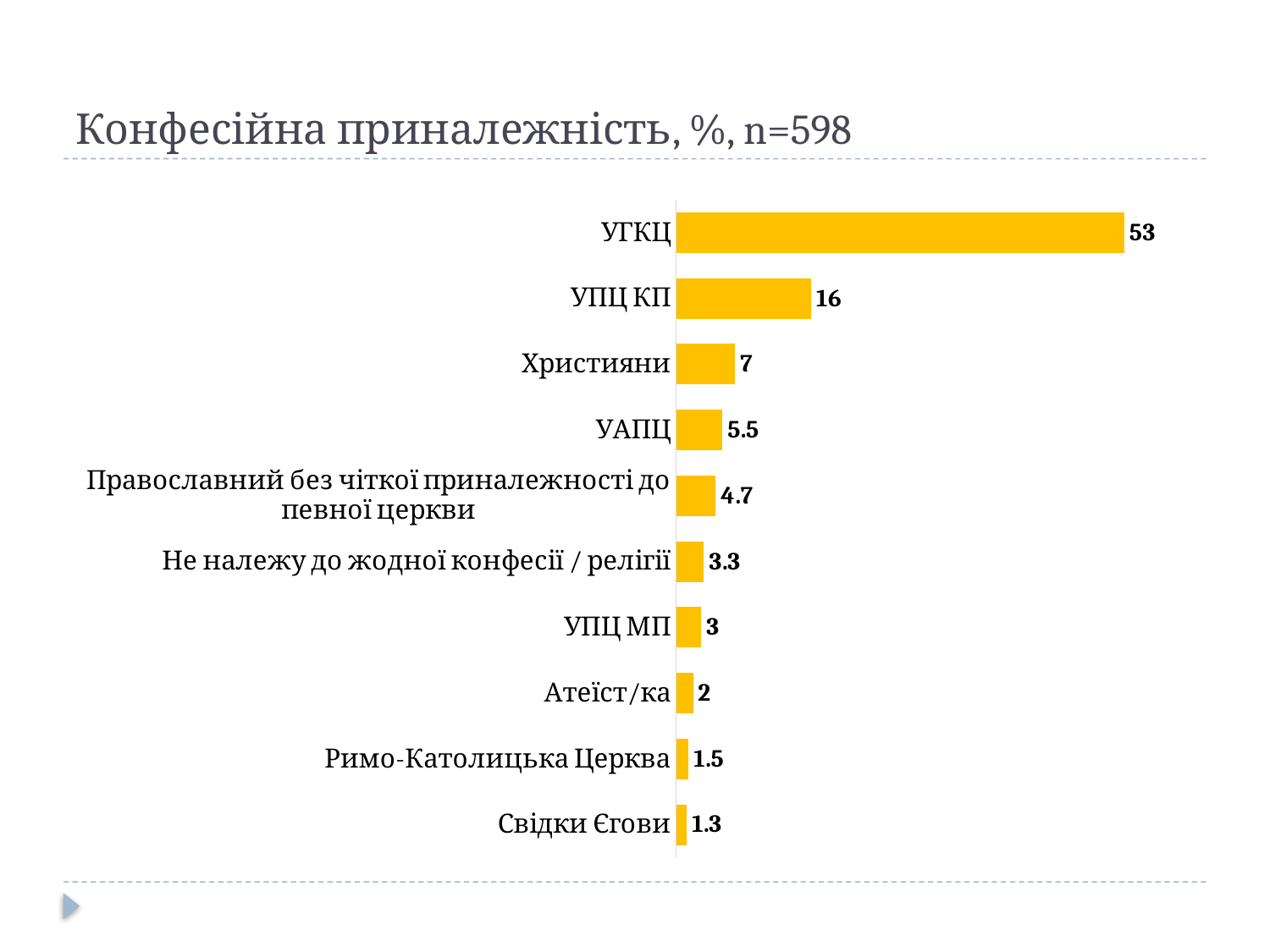
What is the difference between the values for УАПЦ and УПЦ МП? 2.5 What is the difference between the values for УГКЦ and УПЦ КП? 37 Which category has the highest value? УГКЦ What is the title of the chart? Конфесійна приналежність, %, n=598 Which is larger, the value for Християни or the value for УАПЦ? Християни What is the value for УПЦ КП? 16 Which category has the lowest value? Свідки Єгови What is the value for Свідки Єгови? 1.3 What kind of chart is shown on the slide? Bar chart How many categories are shown in the chart? 10 What is the value for Православний без чіткої приналежності до певної церкви? 4.7 What is the value for УГКЦ? 53